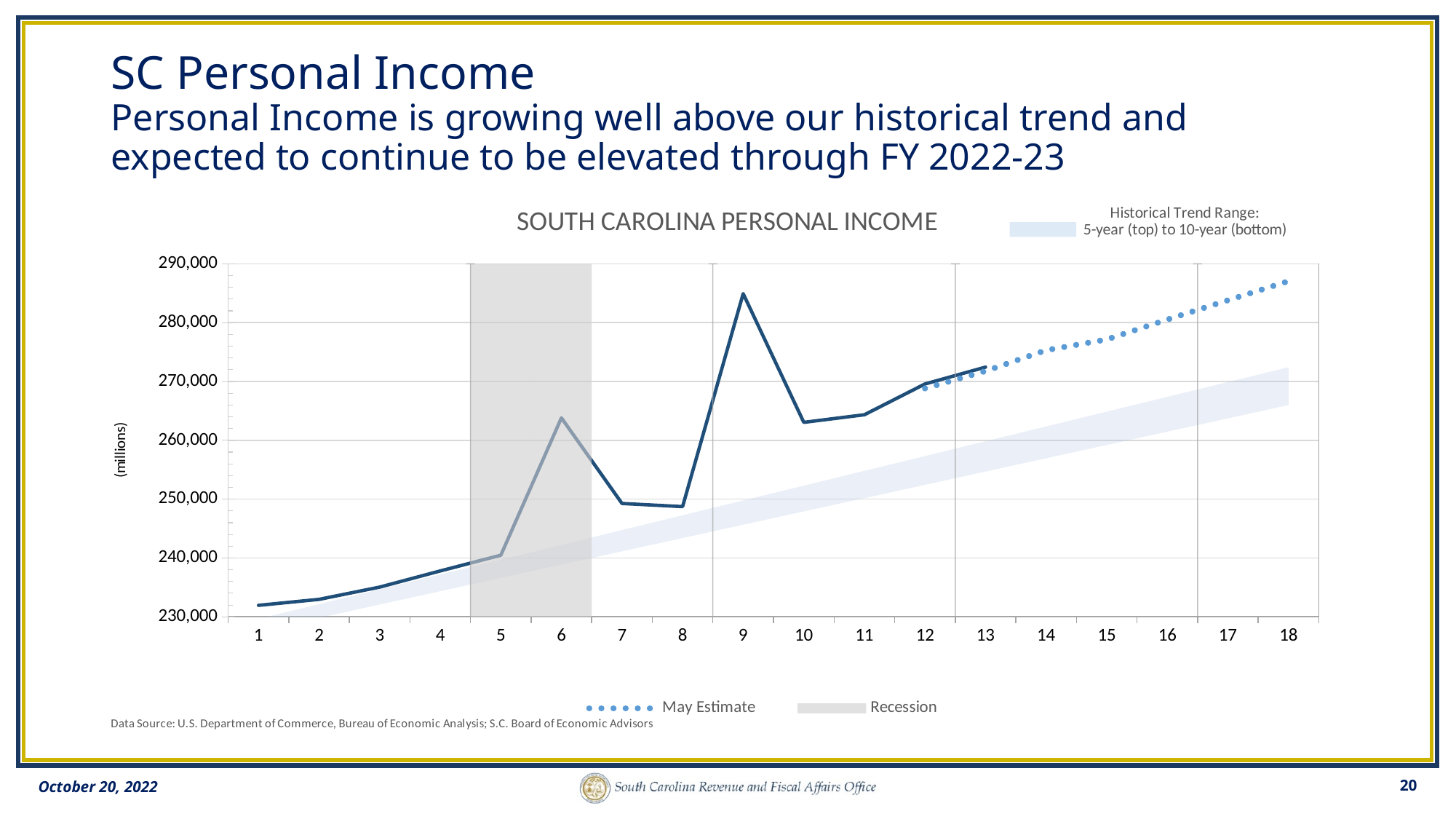
What is the title of the chart? SOUTH CAROLINA PERSONAL INCOME Does the personal income line rise or fall from point 1 to point 6? Rise How many entries does the legend at the bottom of the chart list? 2 Which is larger, the personal income value at point 9 or at point 6? Point 9 What kind of chart is shown on the slide? Line chart How many points are labelled along the x axis of the chart? 18 Is the value of the personal income line at point 10 greater or less than 260,000? greater At which x-axis point is the solid personal income line at its lowest value? 1 Is the May Estimate value at point 18 greater or less than 280,000? greater Is the value of the personal income line at point 9 greater or less than 280,000? greater At which x-axis point does the solid personal income line reach its highest value? 9 Does the personal income line rise or fall between point 9 and point 10? Fall